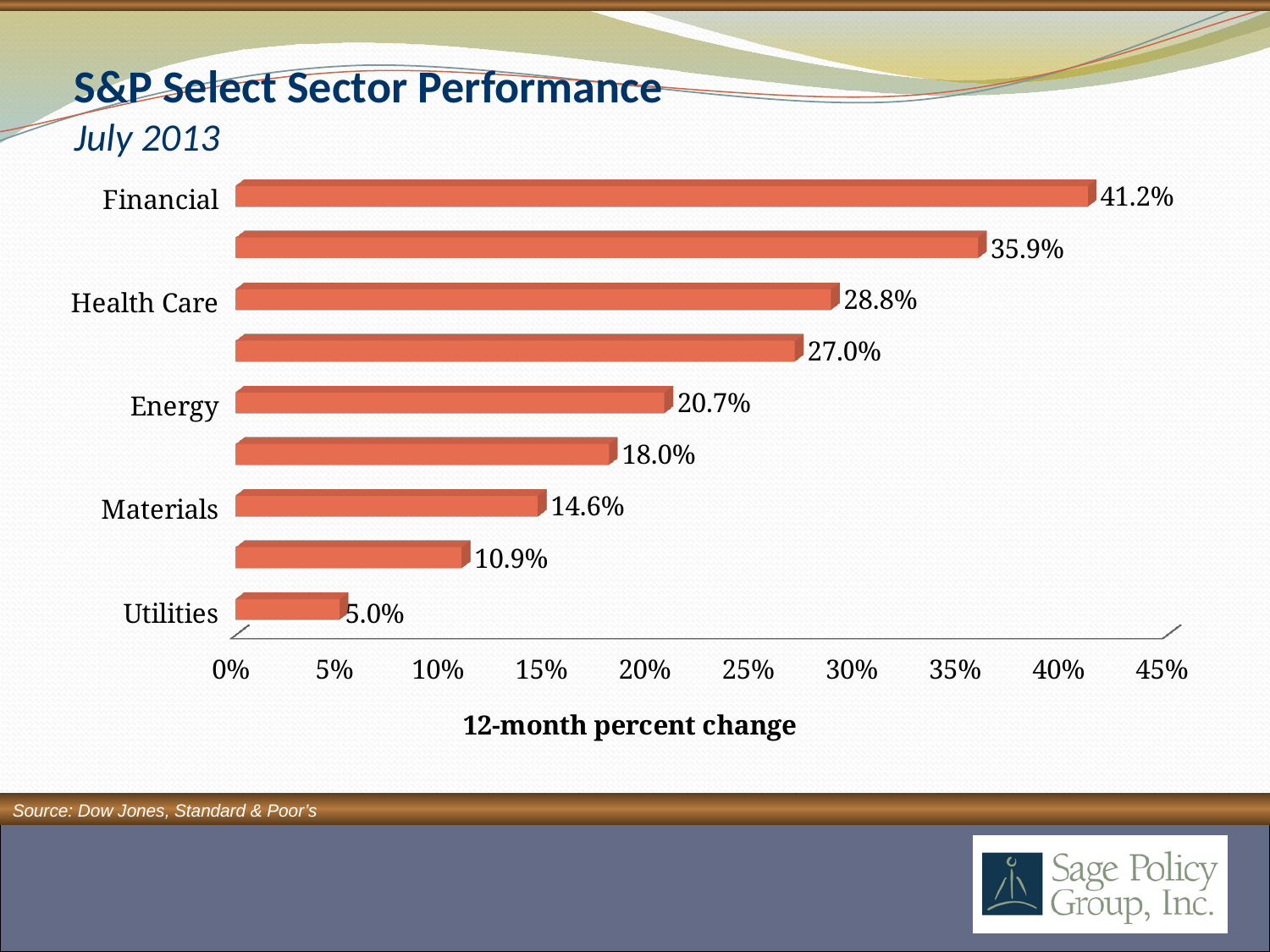
What is the difference between the Energy and Materials values? 6.1% Which sector has the lowest 12-month percent change? Utilities What is the 12-month percent change for Energy? 20.7% What is the difference between the Financial and Health Care values? 12.4% What is the 12-month percent change for Financial? 41.2% What kind of chart is shown on the slide? Bar chart Which is larger, the value for Health Care or the value for Energy? Health Care What is the 12-month percent change for Materials? 14.6% Which sector has the highest 12-month percent change? Financial What is the 12-month percent change for Health Care? 28.8% What is the 12-month percent change for Utilities? 5.0% How many bars are plotted in the chart? 9